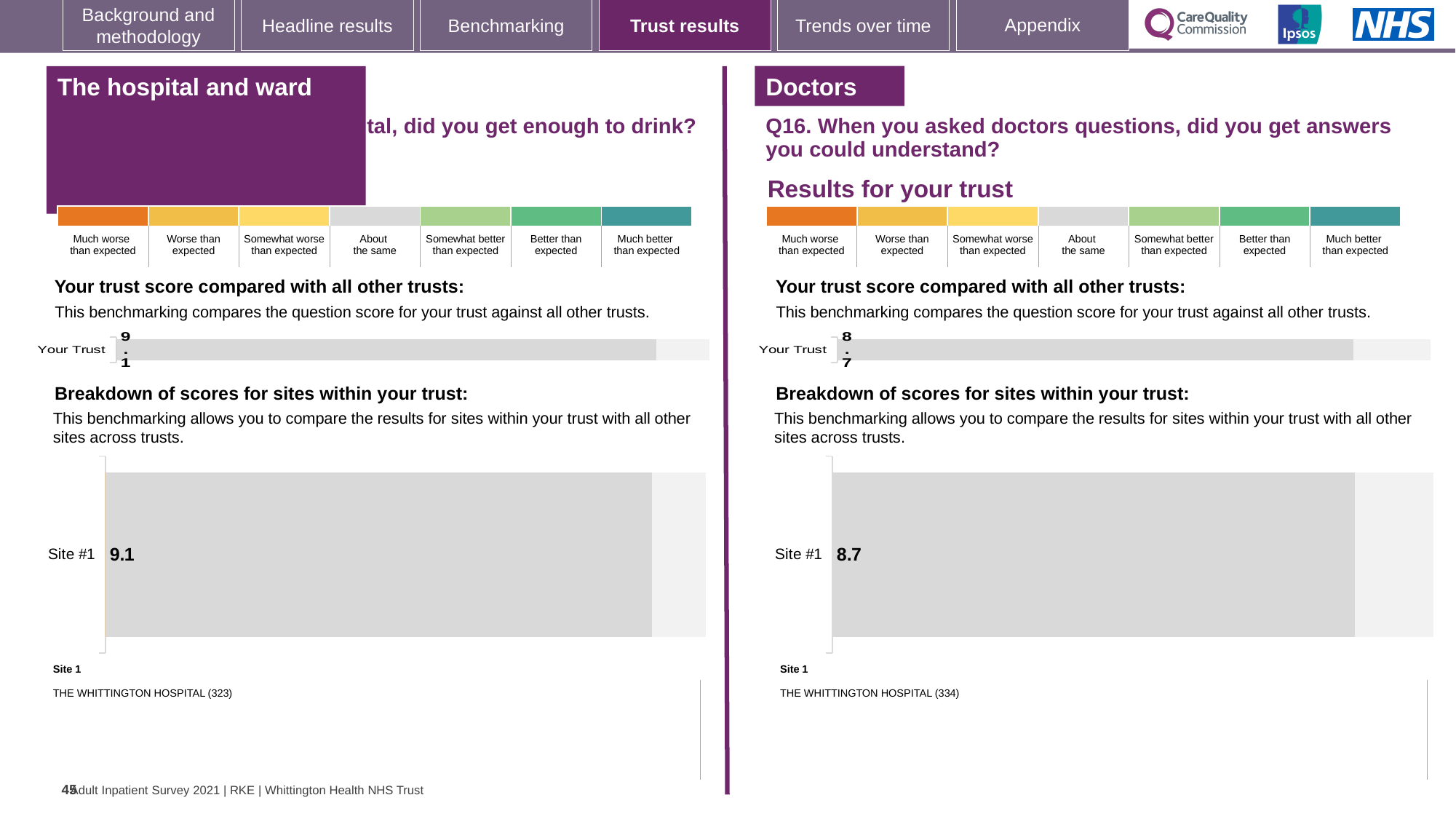
How many sites are shown in the right-hand 'Breakdown of scores for sites within your trust' chart for Q16? 1 In the right-hand 'Breakdown of scores for sites within your trust' chart for Q16, what score is shown for Site #1? 8.7 Which has the higher Your Trust score: the left-hand chart (enough to drink) or the right-hand chart (Q16, doctors' answers)? The left-hand chart (enough to drink) Is the Site #1 score in the right-hand Q16 breakdown chart greater or less than the Site #1 score in the left-hand breakdown chart? less On the right-hand Q16 panel, which hospital is listed as Site 1 below the breakdown chart? THE WHITTINGTON HOSPITAL (334) How many sites are shown in the left-hand 'Breakdown of scores for sites within your trust' chart? 1 On the right-hand chart for Q16 (Doctors), what is the score shown for Your Trust? 8.7 In the left-hand 'Breakdown of scores for sites within your trust' chart, what score is shown for Site #1? 9.1 What type of chart is used to show the Your Trust score on the right-hand Q16 panel? Bar chart On the left-hand chart (The hospital and ward, 'did you get enough to drink?'), what is the score shown for Your Trust? 9.1 How many categories are shown in the colour scale above the right-hand Q16 chart, from 'Much worse than expected' to 'Much better than expected'? 7 What is the difference between the Your Trust score on the left-hand chart (9.1) and the Your Trust score on the right-hand Q16 chart (8.7)? 0.4